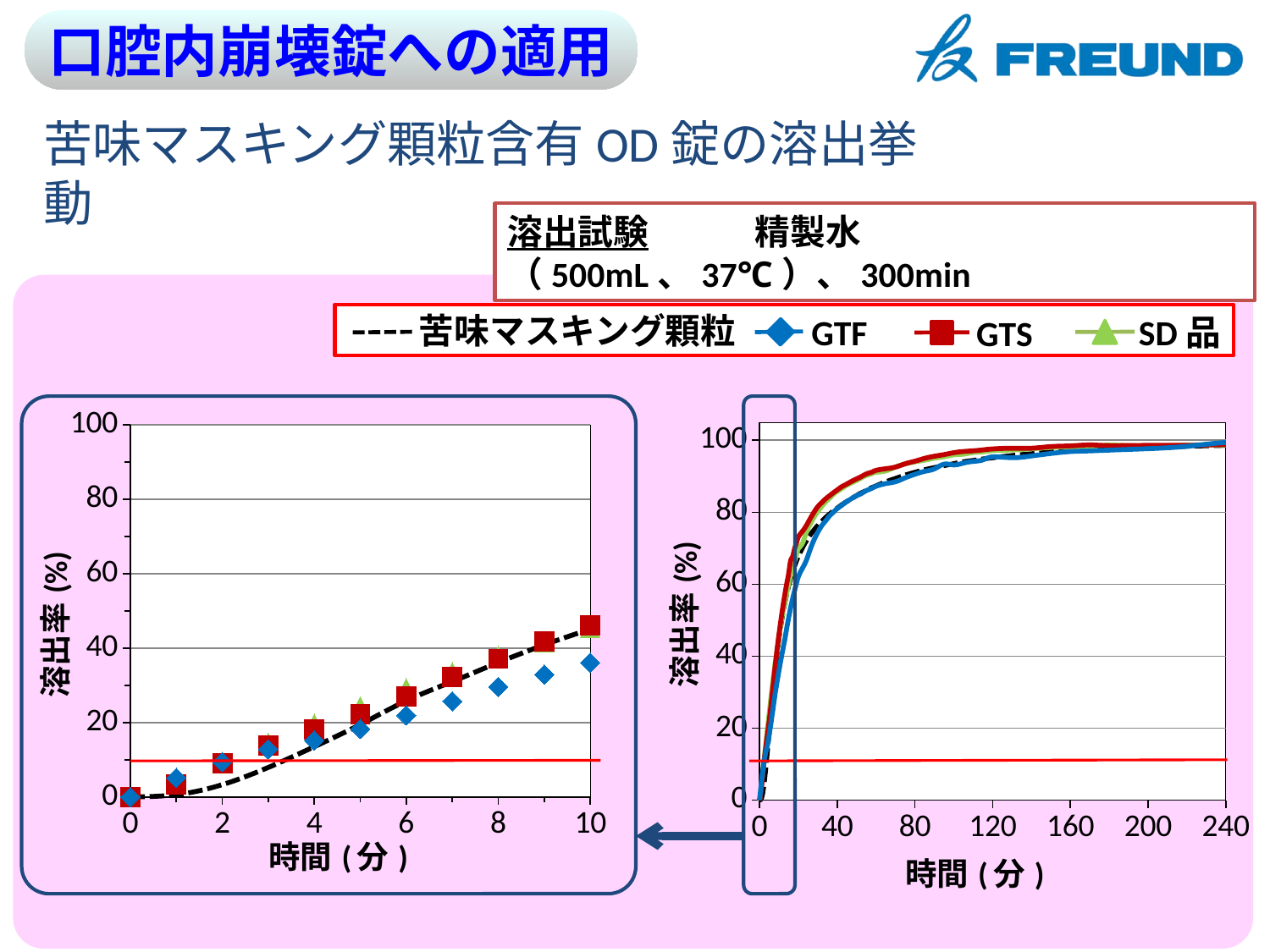
In the left chart (0–10 minutes), is the value for GTS at 2 minutes greater or less than 20? less Which series is drawn as a dashed line in the legend? 苦味マスキング顆粒 In the left chart (0–10 minutes), which is larger at 10 minutes, GTF or GTS? GTS In the left chart (0–10 minutes), is the value for GTS at 10 minutes greater or less than 40? greater In the left chart (0–10 minutes), is the value for GTF at 10 minutes greater or less than 40? less What kind of chart is the left chart (0–10 minutes)? line chart In the right chart (0–240 minutes), do the values rise or fall as time increases? rise What is the y-axis label of the left chart? 溶出率 (%) How many series does the legend list? 4